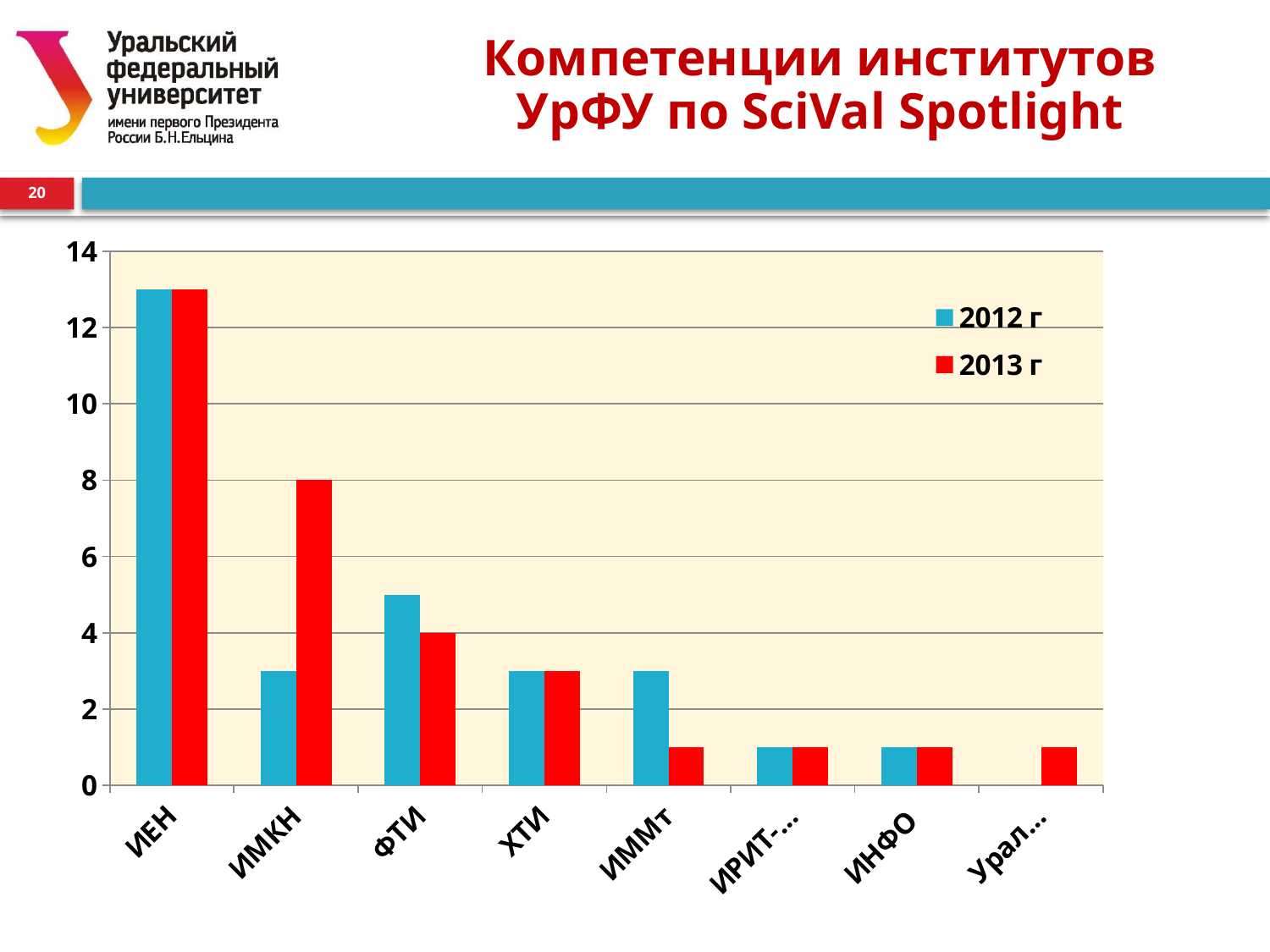
How many categories are shown on the x axis? 8 For ФТИ, which series has the larger value, 2012 г or 2013 г? 2012 г Which category has the highest value in the 2013 г series? ИЕН What is the value for ФТИ in the 2013 г series? 4 Is the value for ИЕН in the 2012 г series greater or less than 12? greater What are the two entries listed in the legend? 2012 г and 2013 г Which category has the highest value in the 2012 г series? ИЕН What kind of chart is shown on the slide? bar chart For ИМКН, which series has the larger value, 2012 г or 2013 г? 2013 г Is the value for ХТИ in the 2012 г series greater or less than 4? less How many series does the legend list? 2 What is the value for ИМКН in the 2013 г series? 8